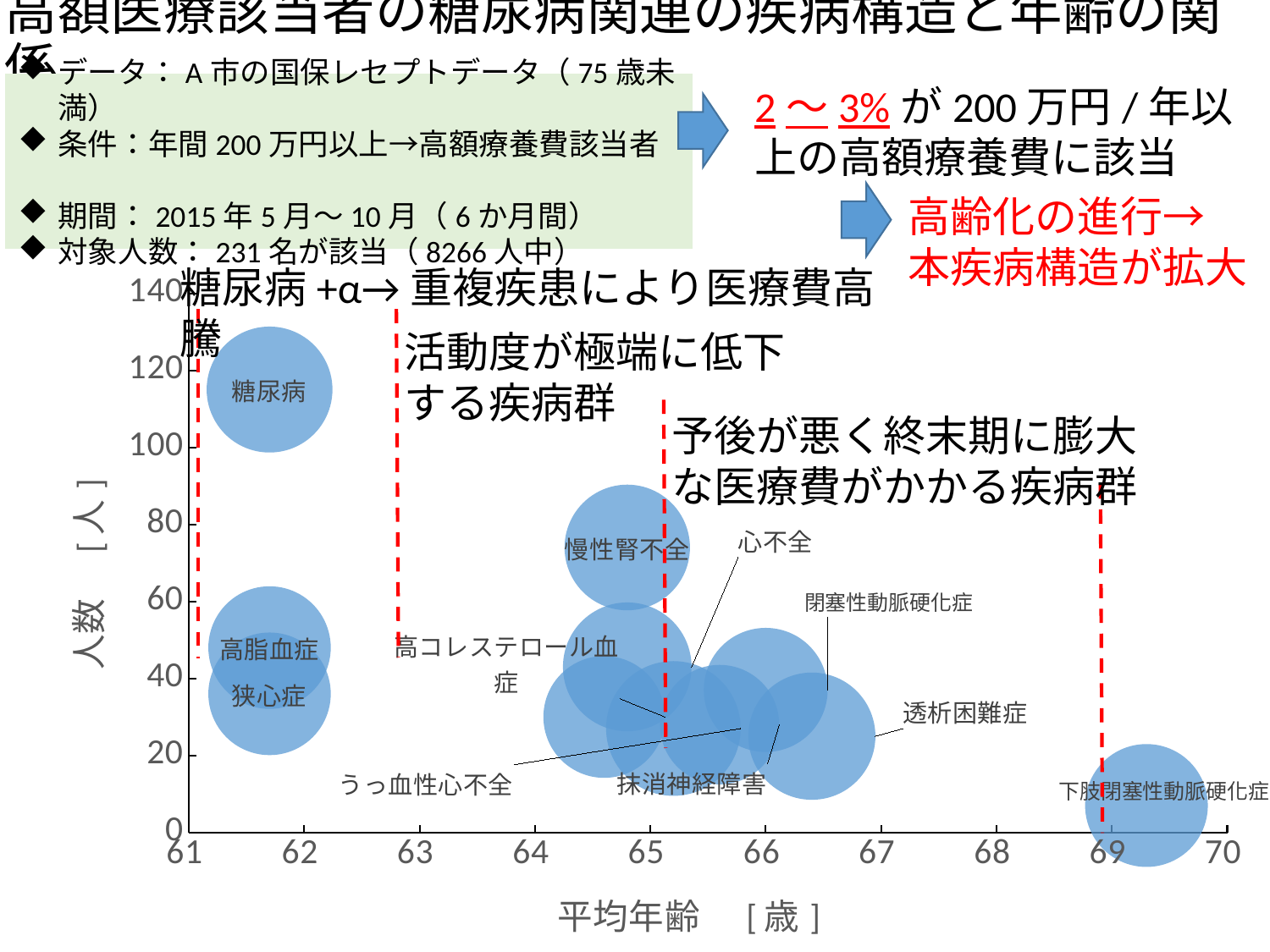
Which has a higher 人数, 糖尿病 or 慢性腎不全? 糖尿病 Which disease has the highest 平均年齢 in the chart? 下肢閉塞性動脈硬化症 Is the 平均年齢 value for 糖尿病 greater or less than 62? less What is the label of the x axis of the chart? 平均年齢 [歳] Which disease has the lowest 人数 in the chart? 下肢閉塞性動脈硬化症 What kind of chart is shown on the slide? bubble chart Which has a higher 平均年齢, 狭心症 or 透析困難症? 透析困難症 What is the label of the y axis of the chart? 人数 [人] Which disease has the highest 人数 in the chart? 糖尿病 Is the 人数 value for 慢性腎不全 greater or less than 60? greater Is the 人数 value for 下肢閉塞性動脈硬化症 greater or less than 20? less